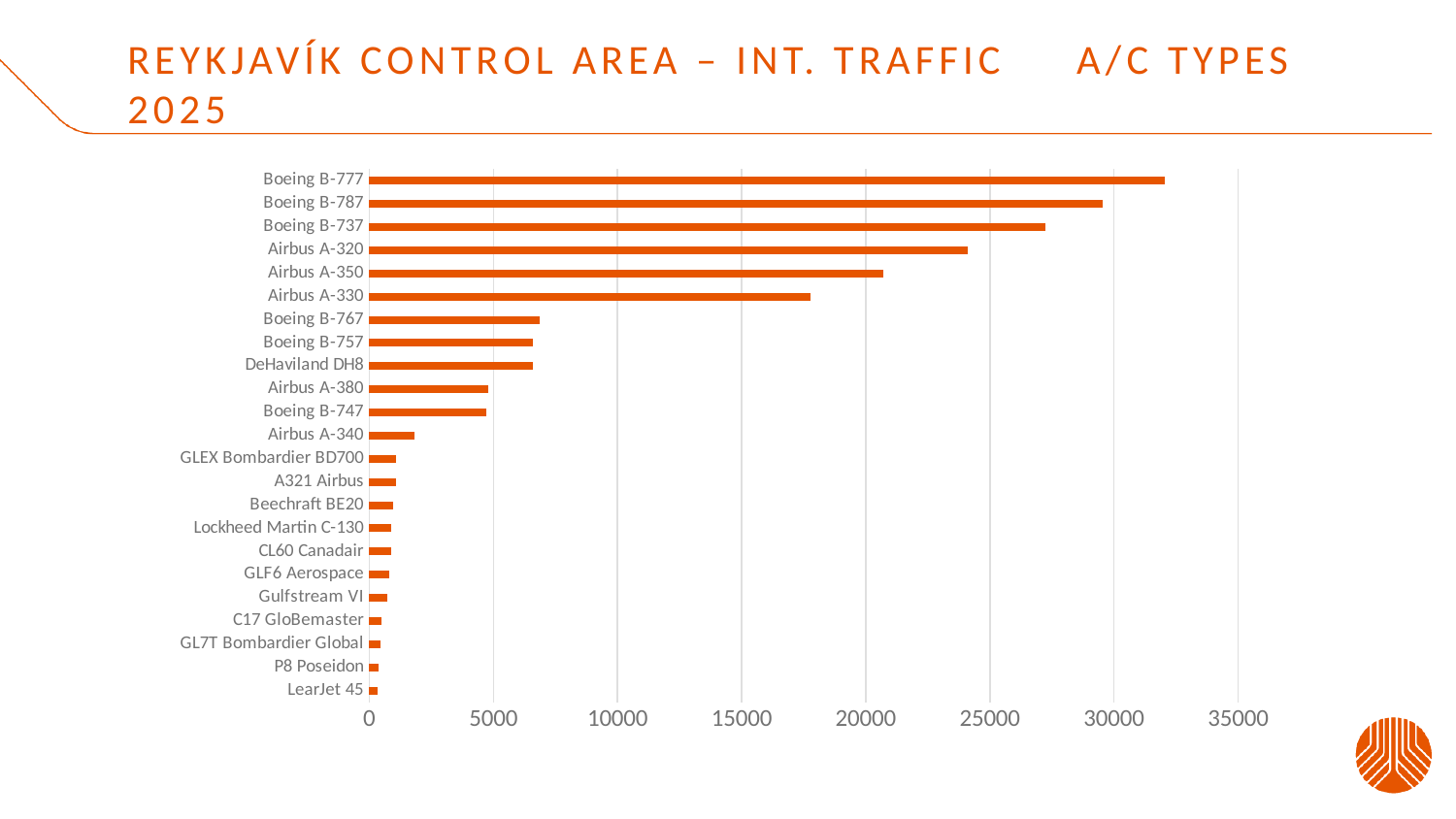
How many aircraft types are listed in the chart? 23 Which has a larger value, Airbus A-340 or Boeing B-747? Boeing B-747 Which has a larger value, Boeing B-787 or Airbus A-320? Boeing B-787 Is the value for Airbus A-330 greater or less than 20000? less What is the title of the slide containing the chart? REYKJAVÍK CONTROL AREA – INT. TRAFFIC A/C TYPES 2025 What kind of chart is shown on the slide? bar chart Is the value for Boeing B-737 greater or less than 25000? greater Is the value for Boeing B-777 greater or less than 30000? greater Which aircraft type has the highest value in the chart? Boeing B-777 Which aircraft type has the lowest value in the chart? LearJet 45